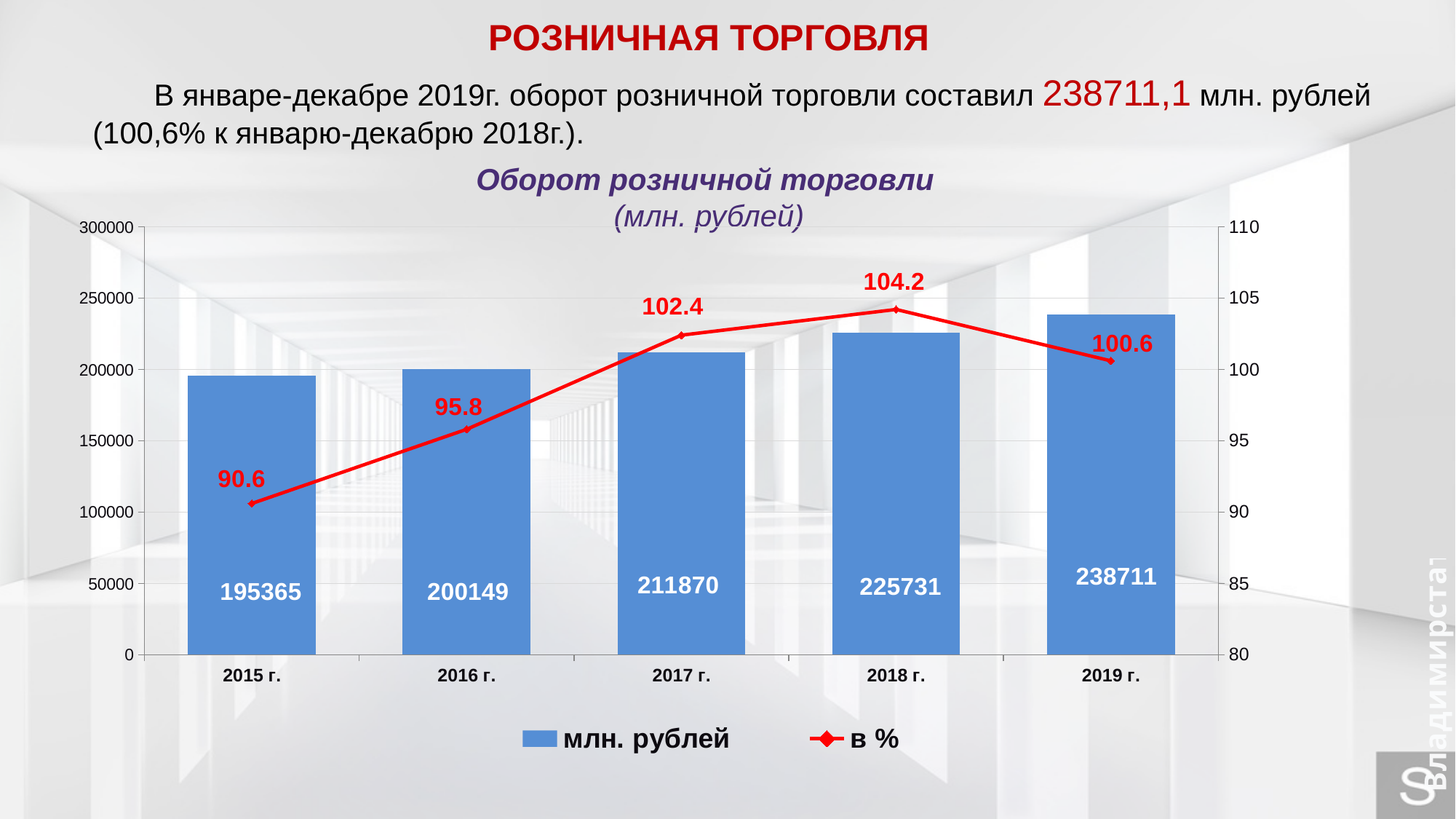
Which year has the lowest "в %" value? 2015 г. Which is larger, the "в %" value for 2018 г. or for 2019 г.? 2018 г. What is the "в %" value for 2016 г.? 95.8 What kind of chart is used for the "млн. рублей" series? bar chart What is the title of the chart? Оборот розничной торговли (млн. рублей) Do the "млн. рублей" values rise or fall from 2015 г. to 2019 г.? rise What is the difference between the "млн. рублей" values for 2019 г. and 2018 г.? 12980 Is the "млн. рублей" value for 2016 г. greater or less than 250000? less How many years are shown on the x axis? 5 How many series does the legend list? 2 What is the value of the "млн. рублей" bar for 2017 г.? 211870 Which year has the highest "млн. рублей" value? 2019 г.